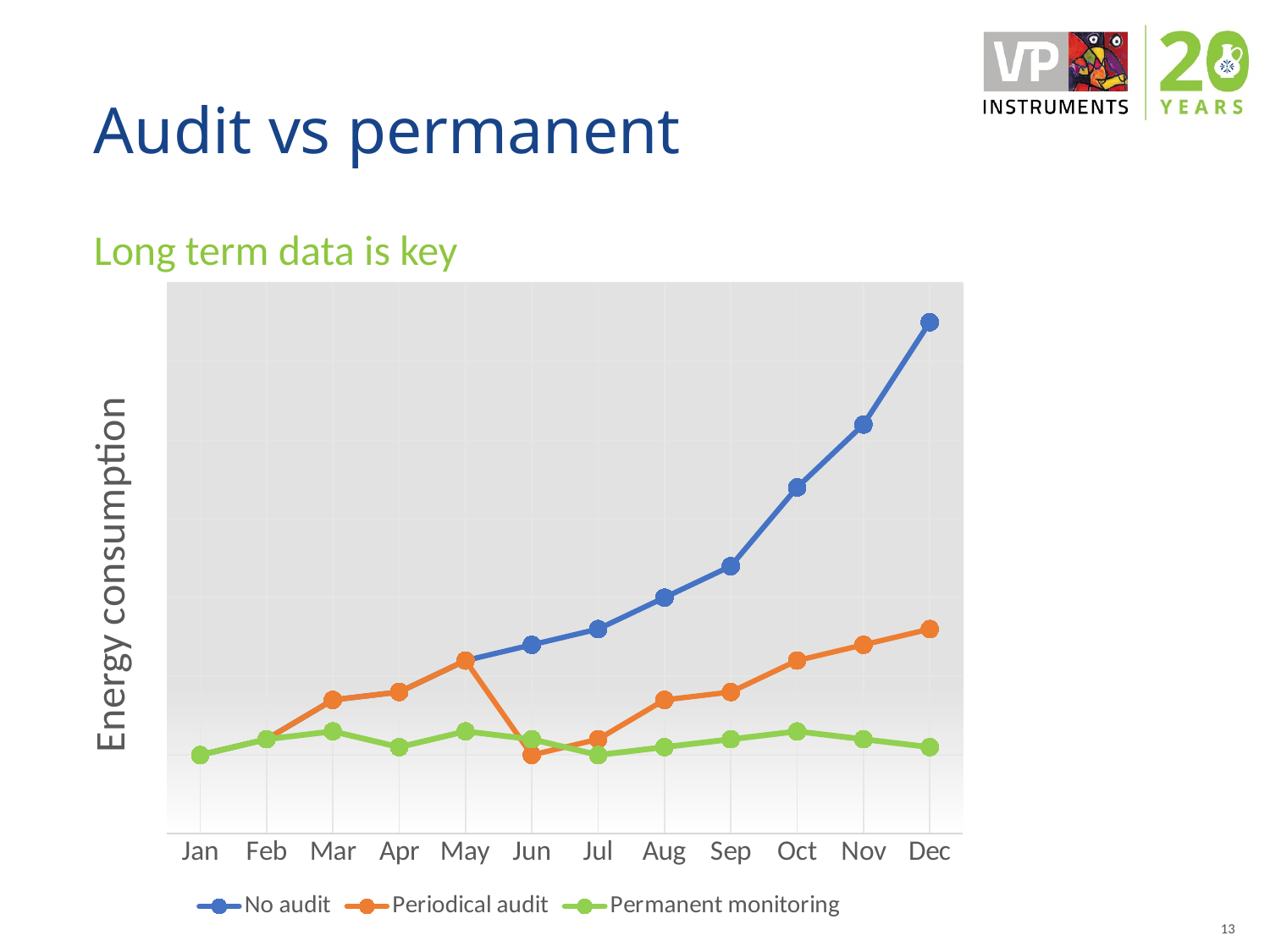
In which month does the No audit series reach its highest value? Dec In which month is the Periodical audit series at its lowest value? Jan and Jun (tied) Does the No audit series rise or fall from Jan to Dec? Rise Which series is drawn in green? Permanent monitoring What kind of chart is shown on the slide? Line chart Which series has the highest value in Dec? No audit Which series has the lowest value in Dec? Permanent monitoring How many months are plotted along the x axis? 12 In which month does the Periodical audit series reach its highest value? Dec How many series does the legend list? 3 In Oct, is the value for No audit higher or lower than the value for Periodical audit? Higher What is the label on the y axis? Energy consumption